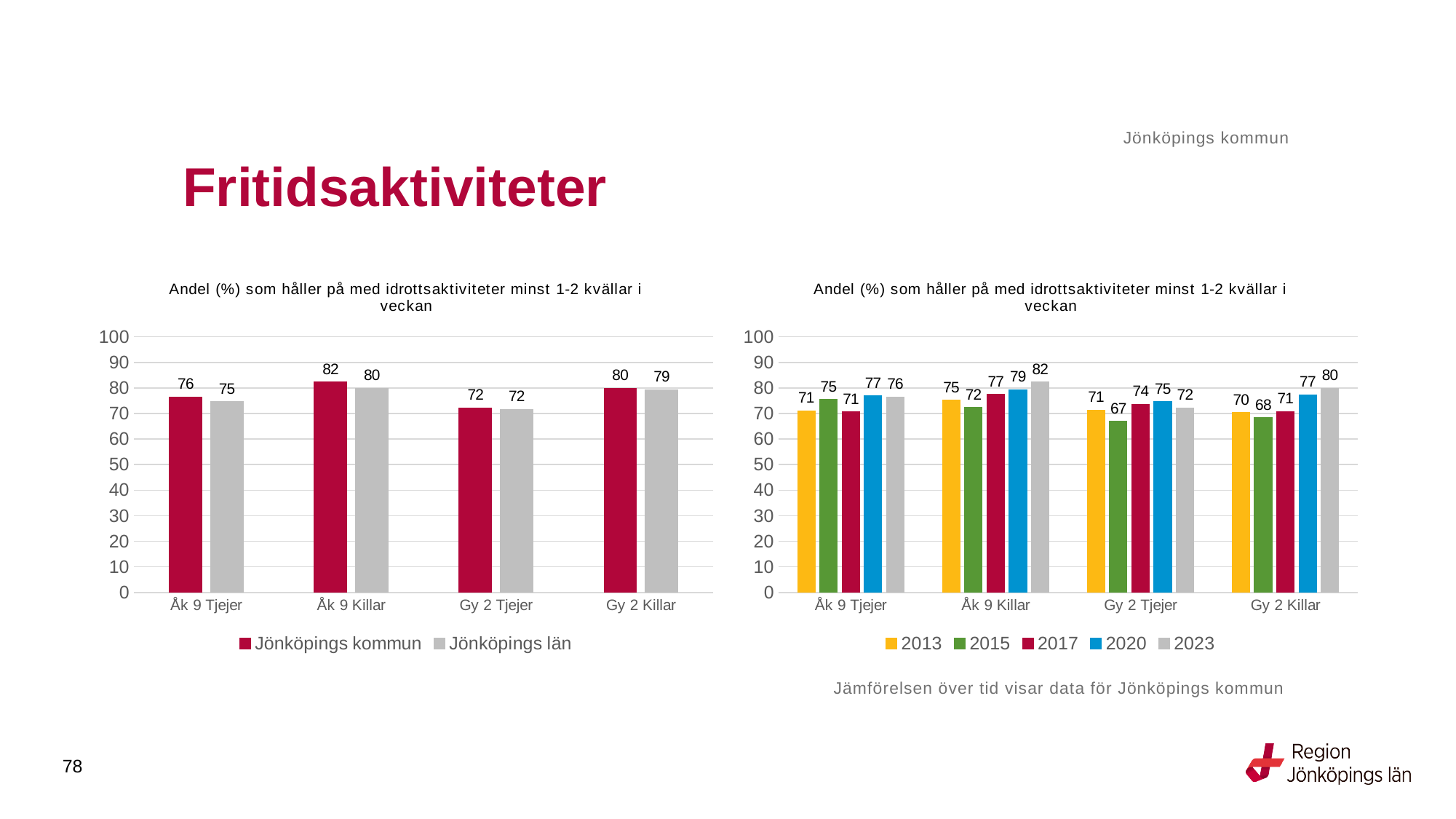
In the left chart, which category has the highest value for Jönköpings kommun? Åk 9 Killar In the right chart, which year has the lowest value for Gy 2 Tjejer? 2015 In the right chart, what is the difference between the 2023 and 2013 values for Gy 2 Killar? 10 In the right chart, is the value for 2023 larger for Åk 9 Killar or for Gy 2 Killar? Åk 9 Killar In the right chart, what is the value for 2020 for Gy 2 Tjejer? 75 In the left chart, which category has the lowest value for Jönköpings län? Gy 2 Tjejer In the left chart, what is the difference between Jönköpings kommun and Jönköpings län for Åk 9 Killar? 2 In the left chart, what is the value for Jönköpings kommun for Åk 9 Killar? 82 In the left chart, how many series does the legend list? 2 In the left chart, what is the value for Jönköpings län for Gy 2 Killar? 79 In the right chart, how many series does the legend list? 5 In the right chart, what is the value for 2013 for Gy 2 Killar? 70